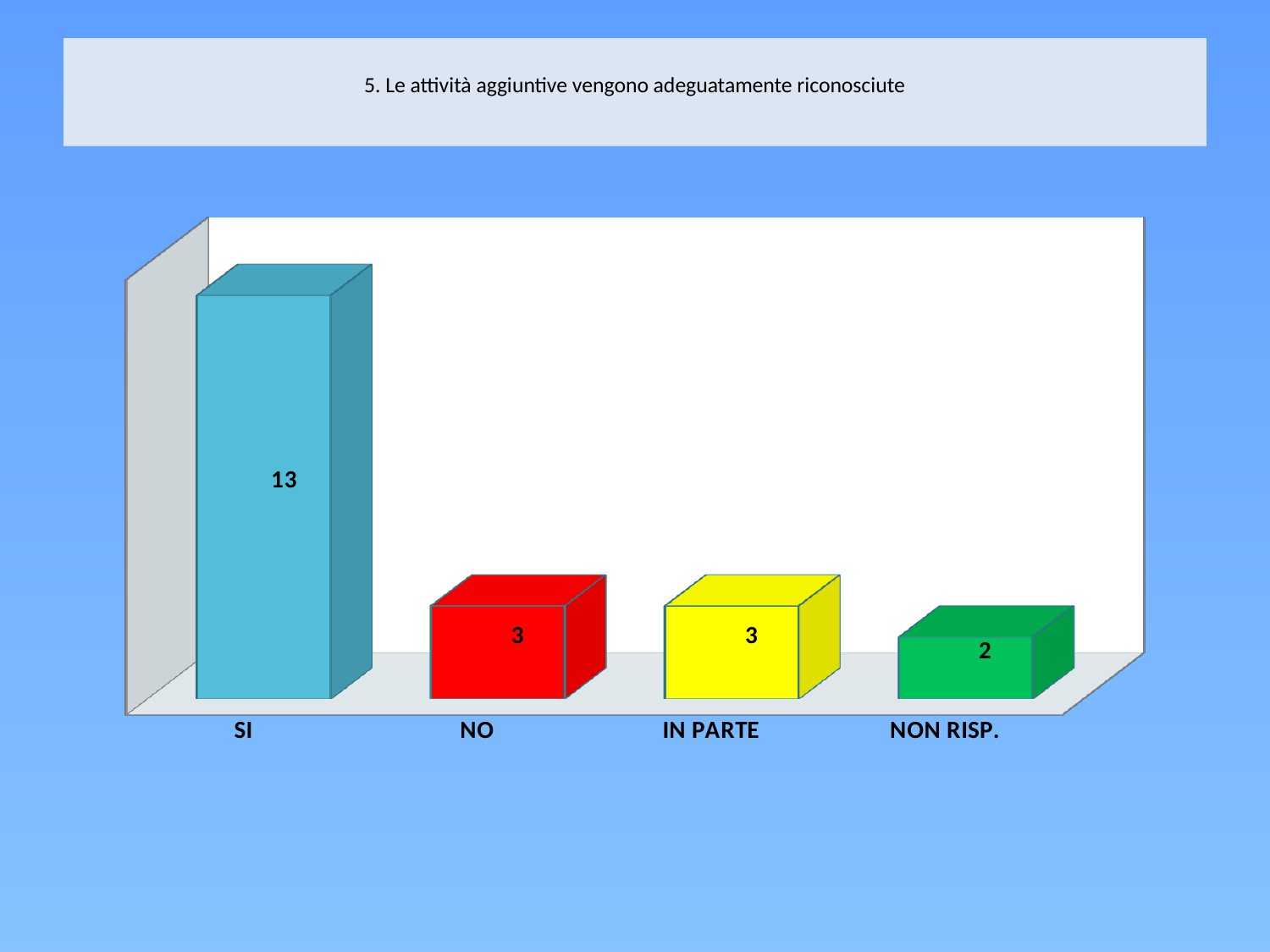
Which is larger, the value for SI or the value for NON RISP.? SI What kind of chart is shown on the slide? bar chart What is the value for SI? 13 What is the value for IN PARTE? 3 Which category has the highest value? SI What is the difference between the values for IN PARTE and NON RISP.? 1 What is the value for NON RISP.? 2 How many categories are shown in the chart? 4 Which category has the lowest value? NON RISP. What colour is the bar for NO? red What is the difference between the values for SI and NO? 10 What is the value for NO? 3